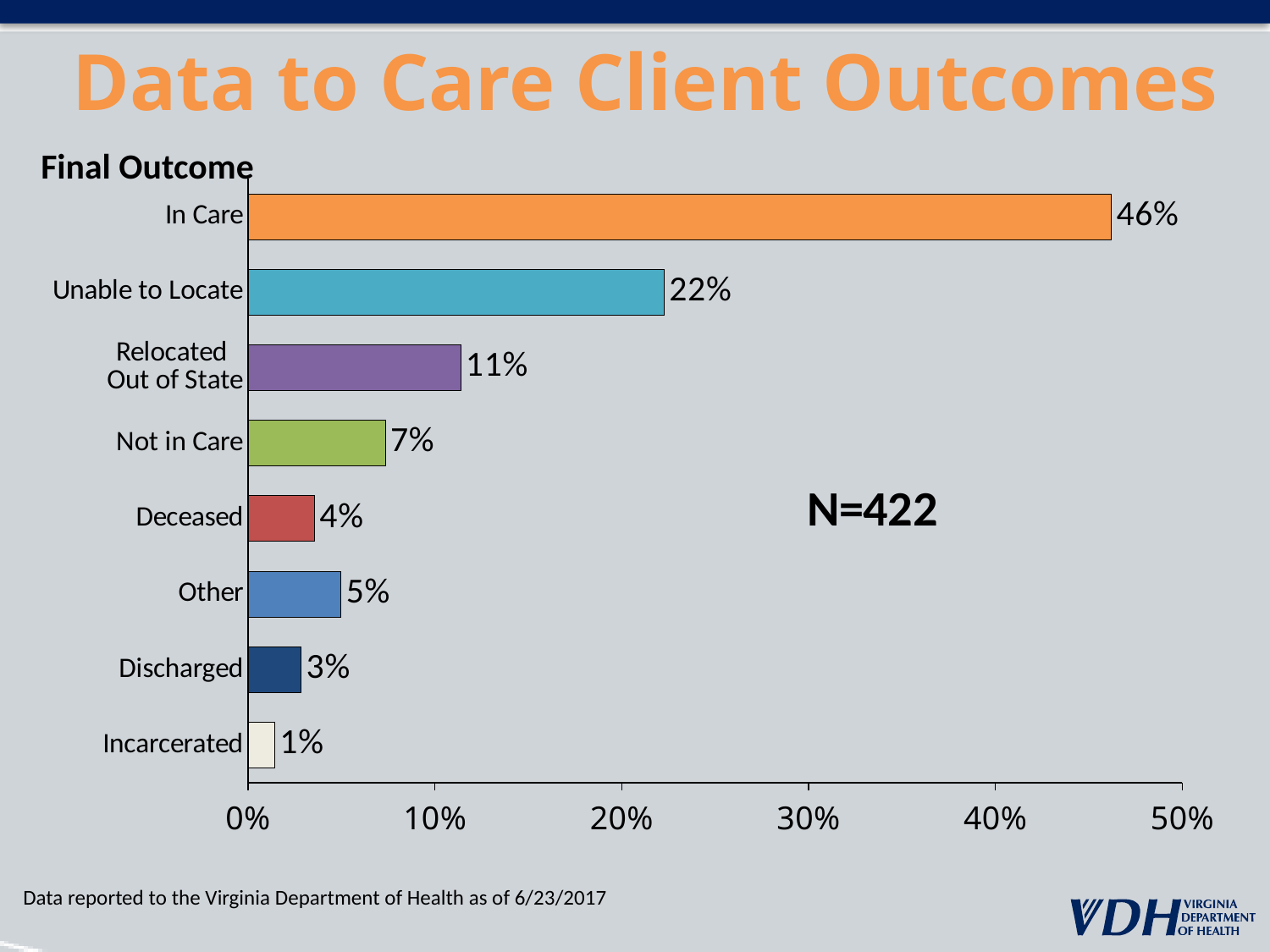
What is the value for Unable to Locate? 22% Which is larger, the value for Other or the value for Deceased? Other What percentage of clients had a final outcome of In Care? 46% Which final outcome has the lowest percentage? Incarcerated What is the N value shown on the chart? N=422 What percentage of clients were Relocated Out of State? 11% How many final outcome categories are shown in the chart? 8 What is the difference between the In Care and Unable to Locate percentages? 24% Which final outcome has the highest percentage? In Care What kind of chart is shown on the slide? bar chart What is the value shown for Discharged? 3% Is the value for Not in Care greater or less than 10%? less